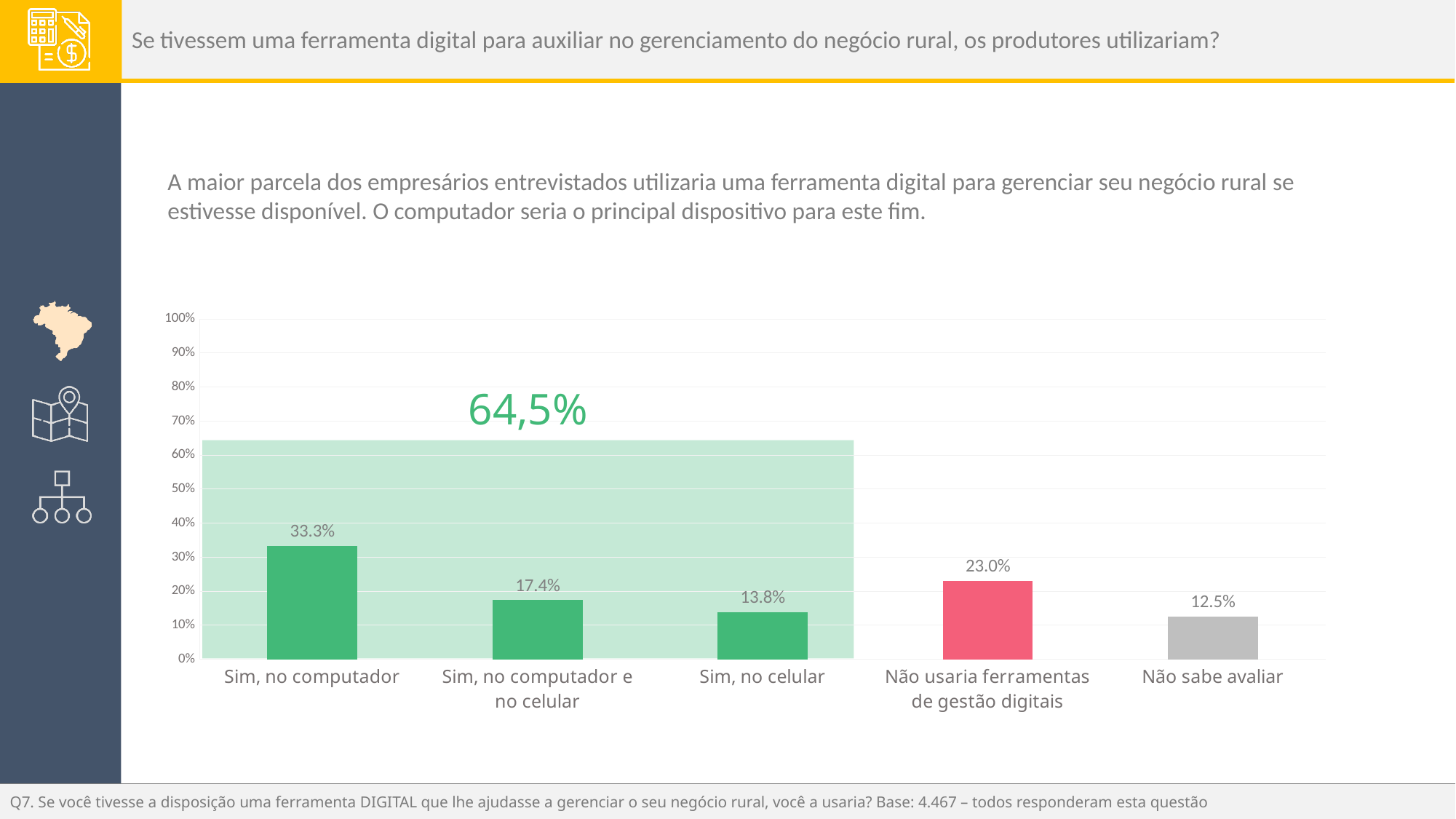
What combined percentage is printed above the green shaded area covering the three "Sim" categories? 64,5% What is the value for "Não usaria ferramentas de gestão digitais"? 23.0% What is the difference between "Sim, no computador" and "Não usaria ferramentas de gestão digitais"? 10.3% Which category has the lowest value? Não sabe avaliar Which is larger, "Sim, no computador e no celular" or "Sim, no celular"? Sim, no computador e no celular How many categories are shown on the x axis? 5 What kind of chart is shown on the slide? Bar chart Which category has the highest value? Sim, no computador What is the value for "Sim, no computador e no celular"? 17.4% What is the value for "Sim, no computador"? 33.3% What is the value for "Sim, no celular"? 13.8% What is the value for "Não sabe avaliar"? 12.5%